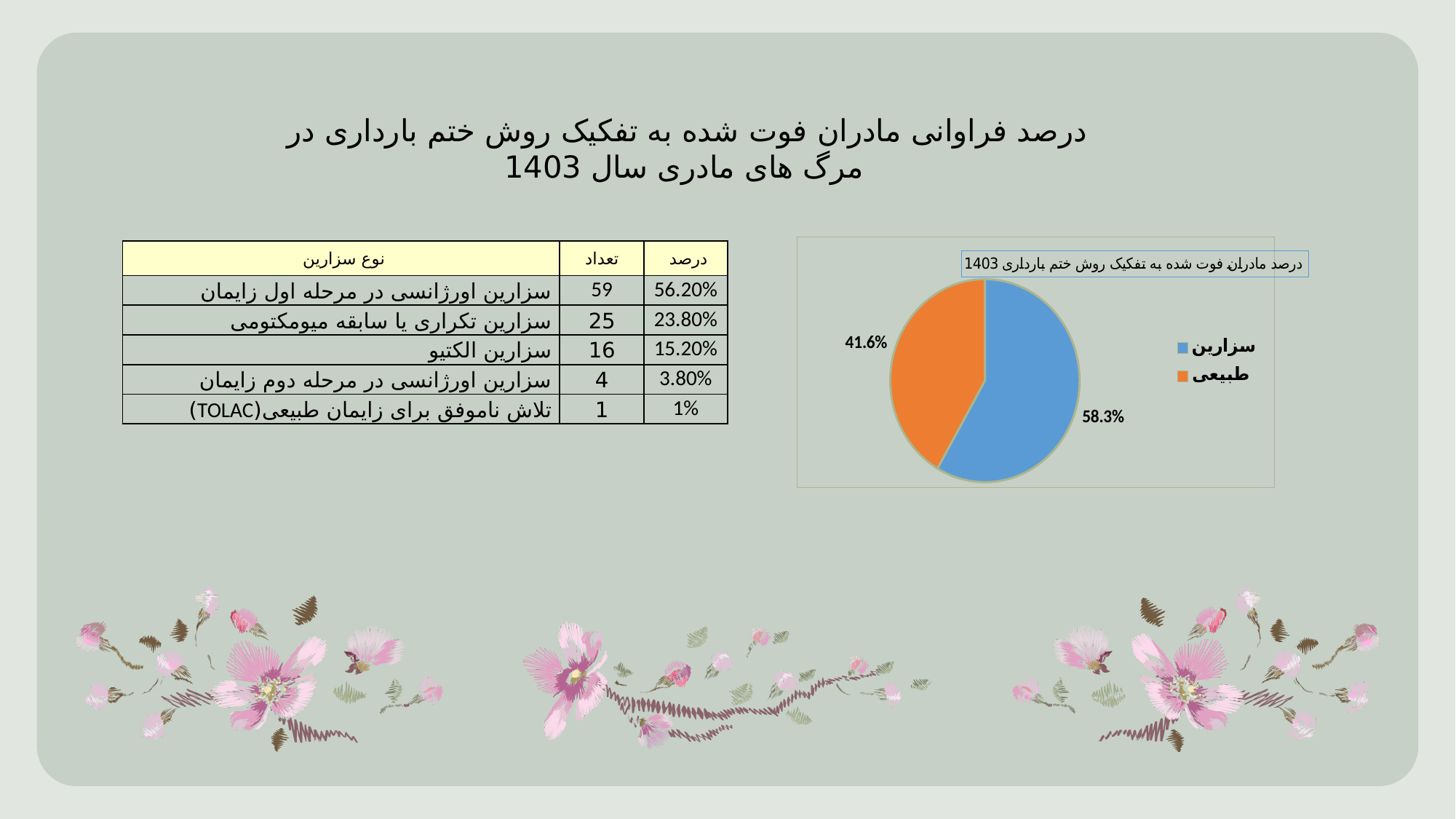
What kind of chart is shown on the slide? pie chart What is the difference between the سزارین and طبیعی slices in the pie chart? 16.7% What is the title of the pie chart? درصد مادران فوت شده به تفکیک روش ختم بارداری 1403 What is the value shown for طبیعی in the pie chart? 41.6% What colour is the سزارین slice in the pie chart? blue Which category has the largest slice in the pie chart? سزارین Which is larger in the pie chart, سزارین or طبیعی? سزارین How many slices does the pie chart have? 2 How many entries does the pie chart legend list? 2 Is the share of سزارین in the pie chart greater or less than 50%? greater What is the value shown for سزارین in the pie chart? 58.3% Which category has the smallest slice in the pie chart? طبیعی